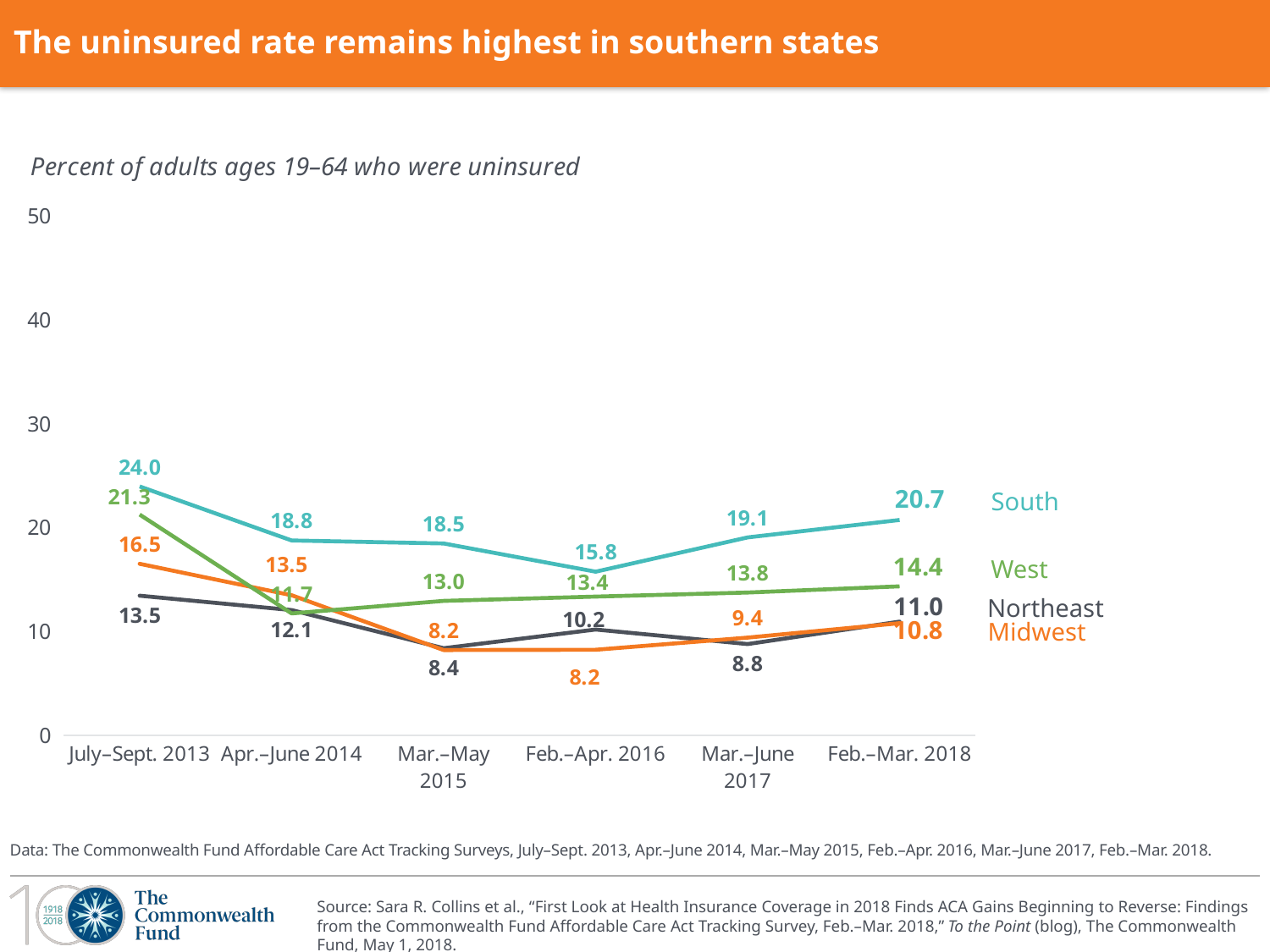
What was the uninsured rate for the Northeast in Mar.–May 2015? 8.4 What was the uninsured rate for the South in July–Sept. 2013? 24.0 How many regions (series) are plotted on the chart? 4 Which was higher in Apr.–June 2014, the uninsured rate for the Midwest or for the West? Midwest What was the uninsured rate for the Midwest in Mar.–June 2017? 9.4 What type of chart is shown on the slide? line chart How many time periods are shown on the x axis? 6 Did the South's uninsured rate rise or fall between Feb.–Apr. 2016 and Feb.–Mar. 2018? rise Which region had the highest uninsured rate in Feb.–Mar. 2018? South Which region had the lowest uninsured rate in Feb.–Apr. 2016? Midwest What is the difference between the South's uninsured rate in July–Sept. 2013 and in Feb.–Mar. 2018? 3.3 What was the uninsured rate for the West in Feb.–Mar. 2018? 14.4